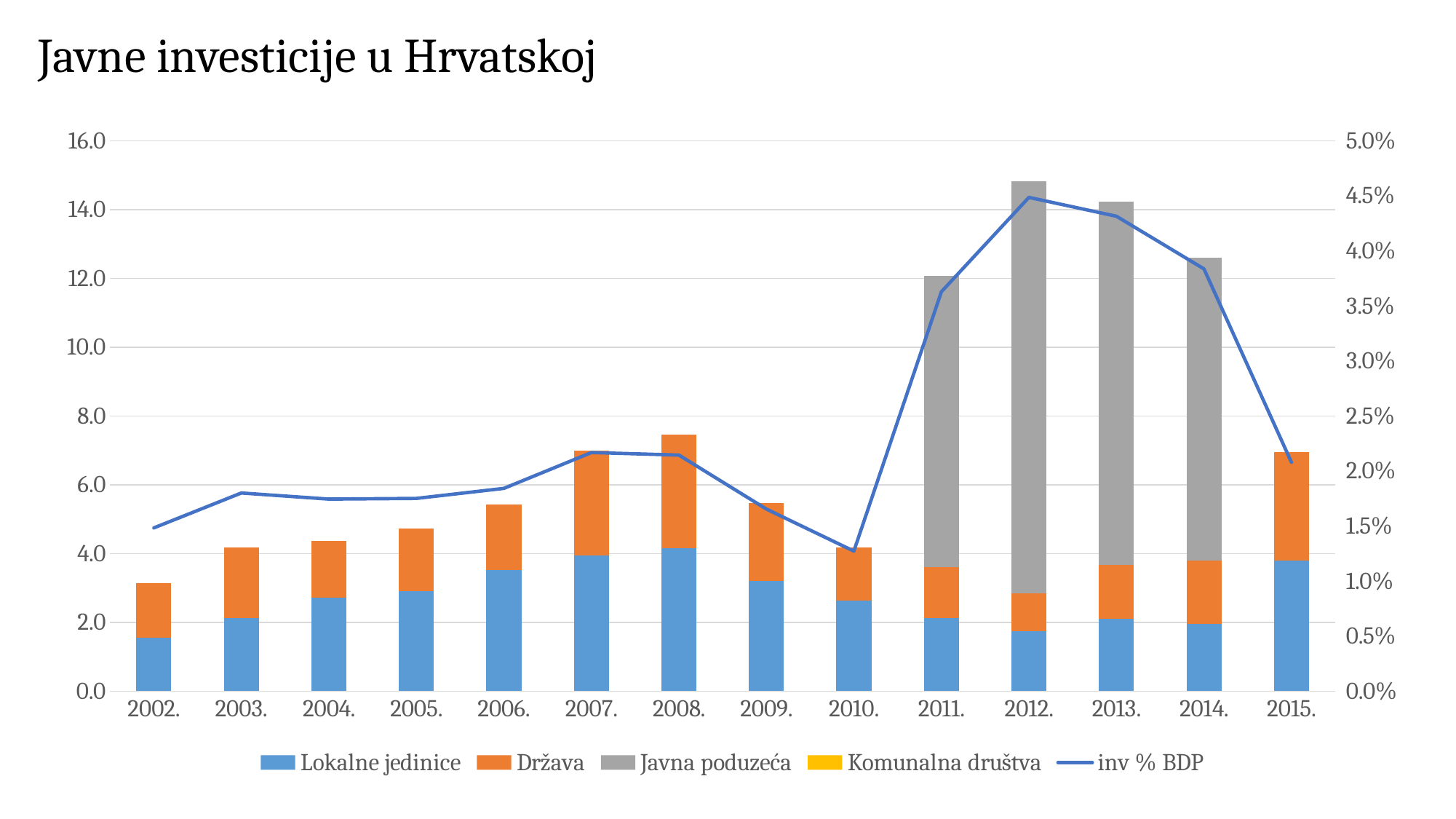
Which stacked bar is taller, 2013. or 2014.? 2013. Does the inv % BDP line rise or fall from 2012. to 2015.? fall Is the total of the stacked bar for 2008. greater or less than 8.0? less Is the total of the stacked bar for 2012. greater or less than 14.0? greater What is the title of the chart? Javne investicije u Hrvatskoj Which year has the tallest stacked bar? 2012. How many years are shown on the x axis? 14 Is the inv % BDP value for 2010. greater or less than 1.5%? less How many series does the legend list? 5 What kind of chart is shown on the slide? Stacked bar chart with a line In which year does the inv % BDP line reach its highest point? 2012. Which year has the shortest stacked bar? 2002.